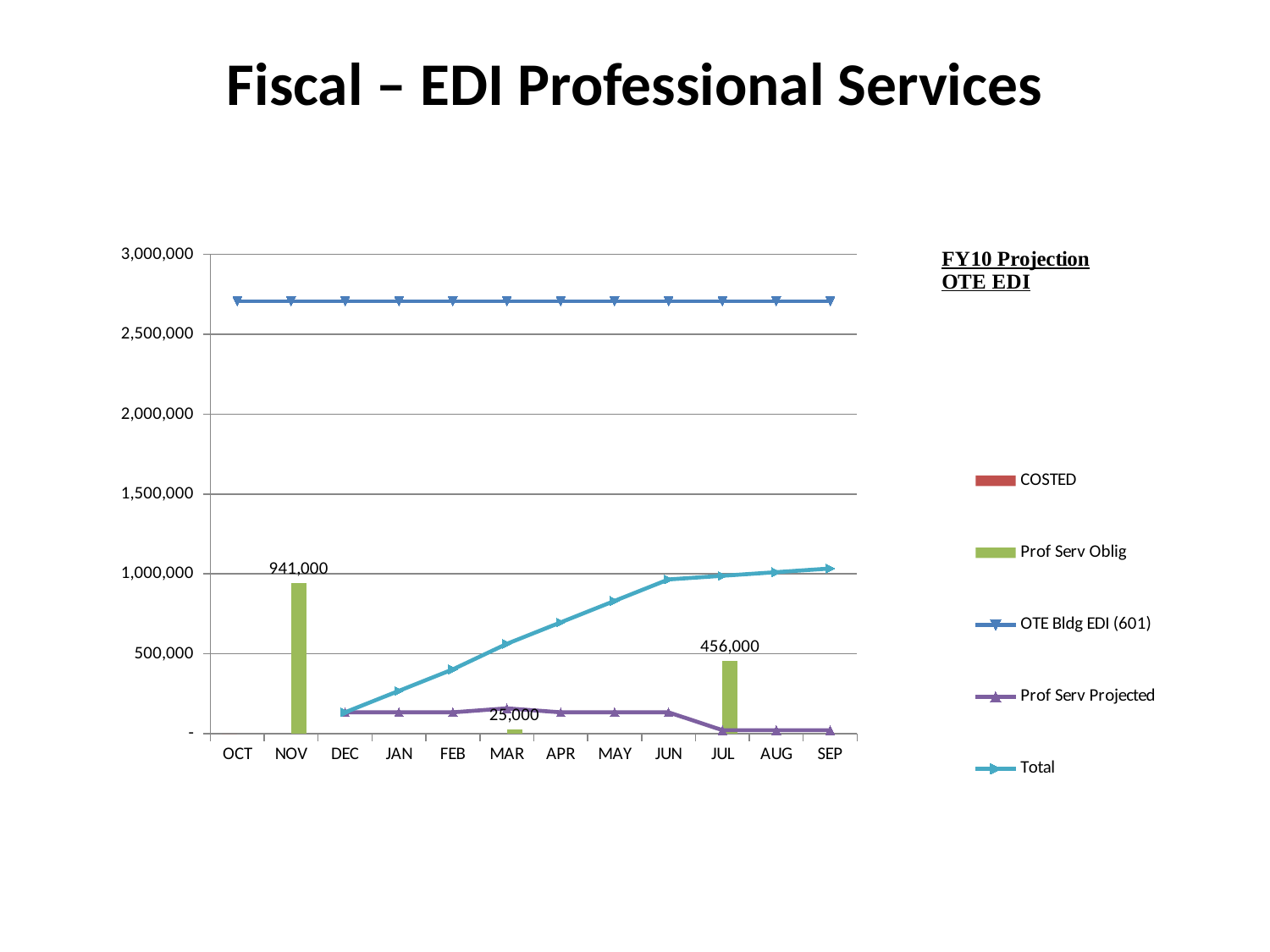
How many series does the legend list? 5 What is the Prof Serv Oblig value for MAR? 25,000 What is the Prof Serv Oblig value for NOV? 941,000 Which of the labelled Prof Serv Oblig bars is the lowest? MAR Which is larger, the Prof Serv Oblig value for NOV or for JUL? NOV Which month has the highest Prof Serv Oblig bar? NOV What is the Prof Serv Oblig value for JUL? 456,000 How many months are shown on the x axis? 12 Does the Total line rise or fall from DEC to SEP? rise Is the OTE Bldg EDI (601) value for OCT greater or less than 2,500,000? greater Is the Total value for JAN greater or less than 500,000? less What is the difference between the Prof Serv Oblig values for NOV and JUL? 485,000